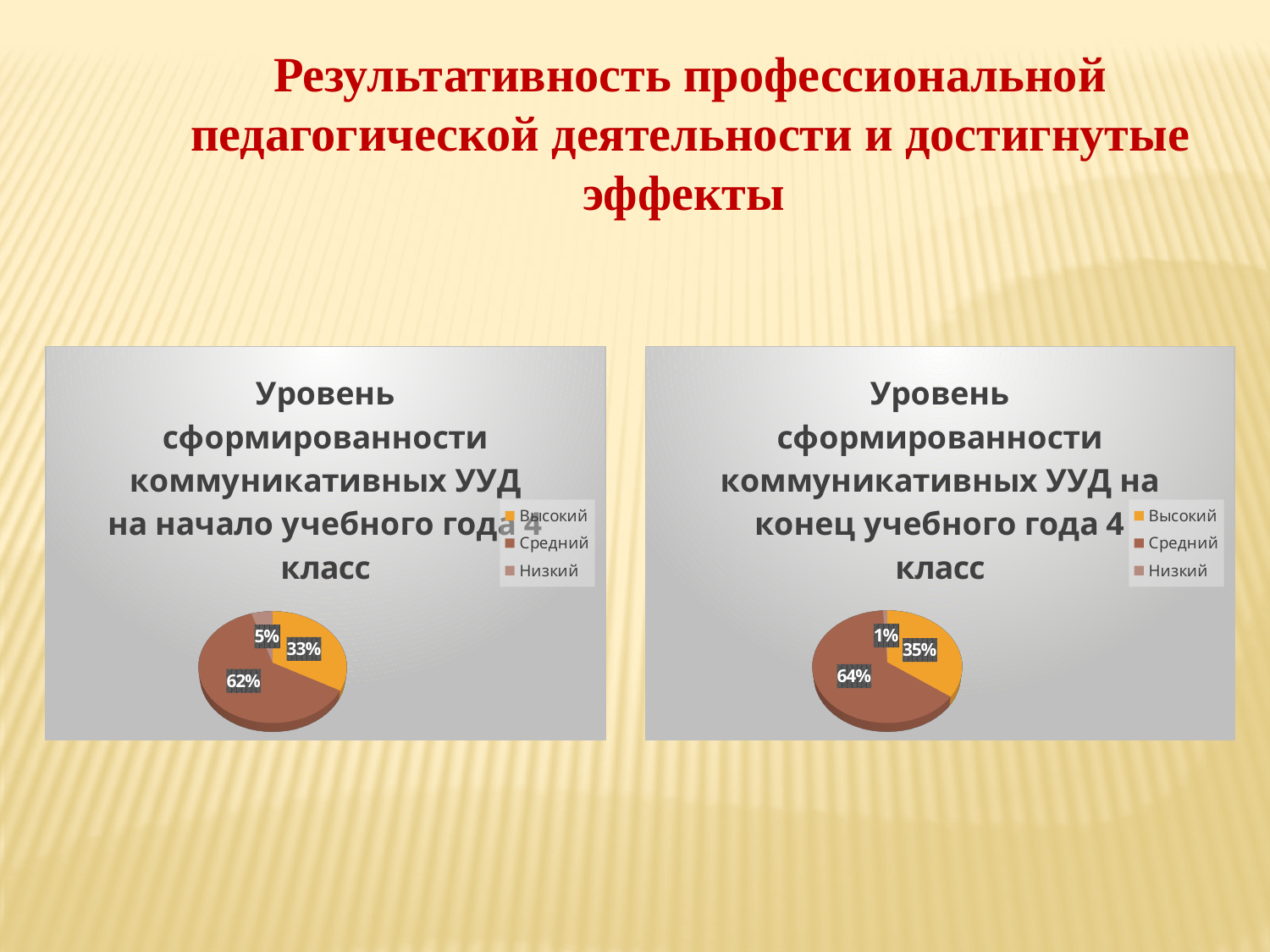
In the left chart, which colour represents the Средний category? Brown In the right chart (end of the school year, 4th grade), what is the difference between the Средний and Высокий shares? 29% In the left chart (start of the school year, 4th grade), what is the value for Высокий? 33% In the right chart (end of the school year, 4th grade), which category has the largest share? Средний In the left chart (start of the school year, 4th grade), which category has the smallest share? Низкий In the right chart (end of the school year, 4th grade), what is the value for Низкий? 1% How many categories does the legend of the right chart list? 3 What type of chart is shown on the left of the slide? Pie chart In the right chart (end of the school year, 4th grade), what is the value for Средний? 64% In the left chart (start of the school year, 4th grade), what is the value for Средний? 62% In the left chart (start of the school year, 4th grade), what is the value for Низкий? 5% Which is larger: the Высокий share in the left chart or the Высокий share in the right chart? The right chart (35%)